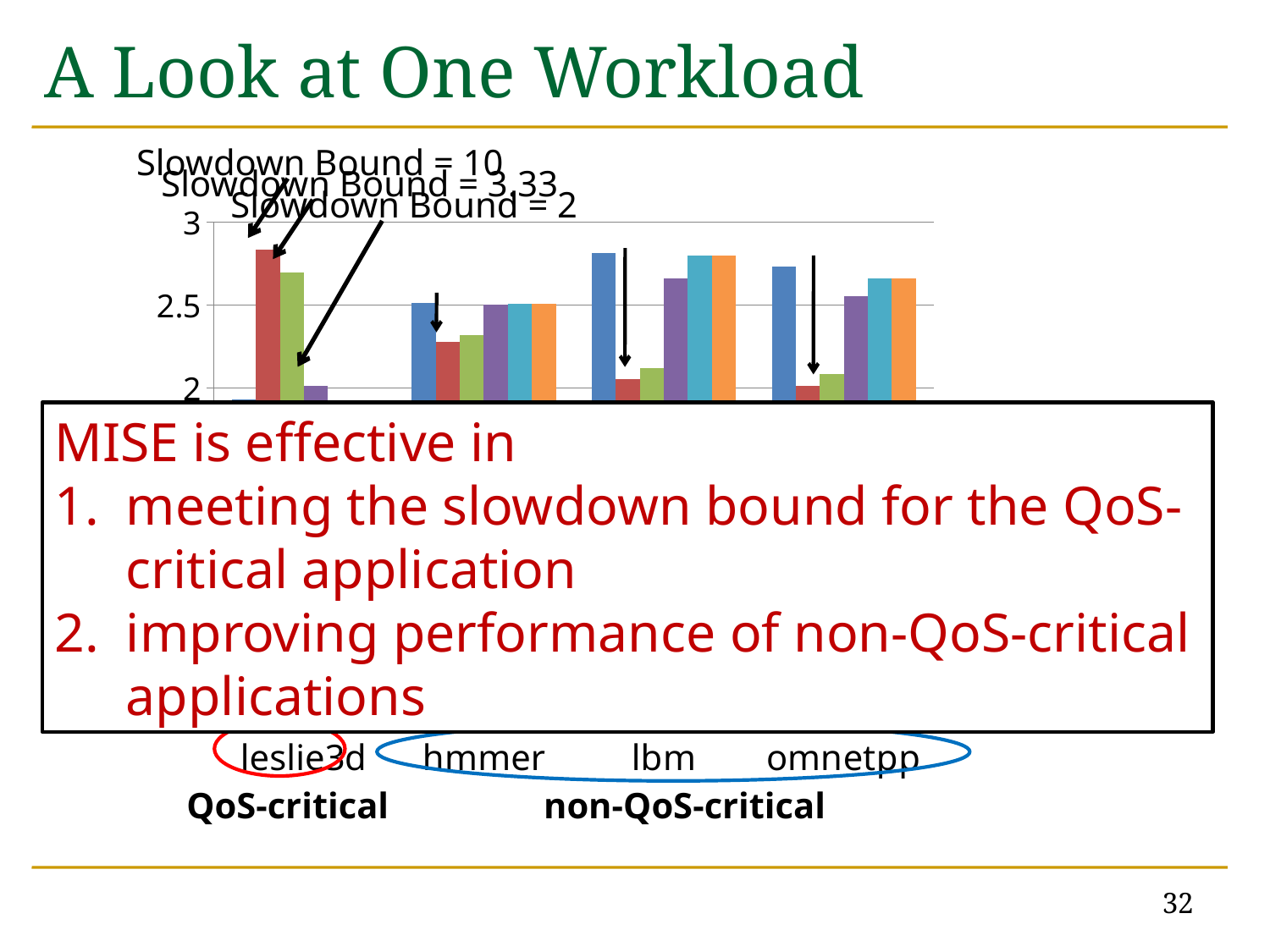
What kind of chart is shown on the slide? bar chart For lbm, which is taller, the blue bar or the red bar? the blue bar How many categories on the x axis are grouped as non-QoS-critical? 3 Is the tallest bar for lbm greater or less than 2.5? greater What three slowdown bound values are annotated above the chart? 10, 3.33 and 2 Which category on the x axis is labeled as QoS-critical? leslie3d For hmmer, which is taller, the blue bar or the green bar? the blue bar Is the red bar for hmmer greater or less than 2.5? less Is the red bar for lbm greater or less than 2.5? less How many application categories are shown along the x axis of the chart? 4